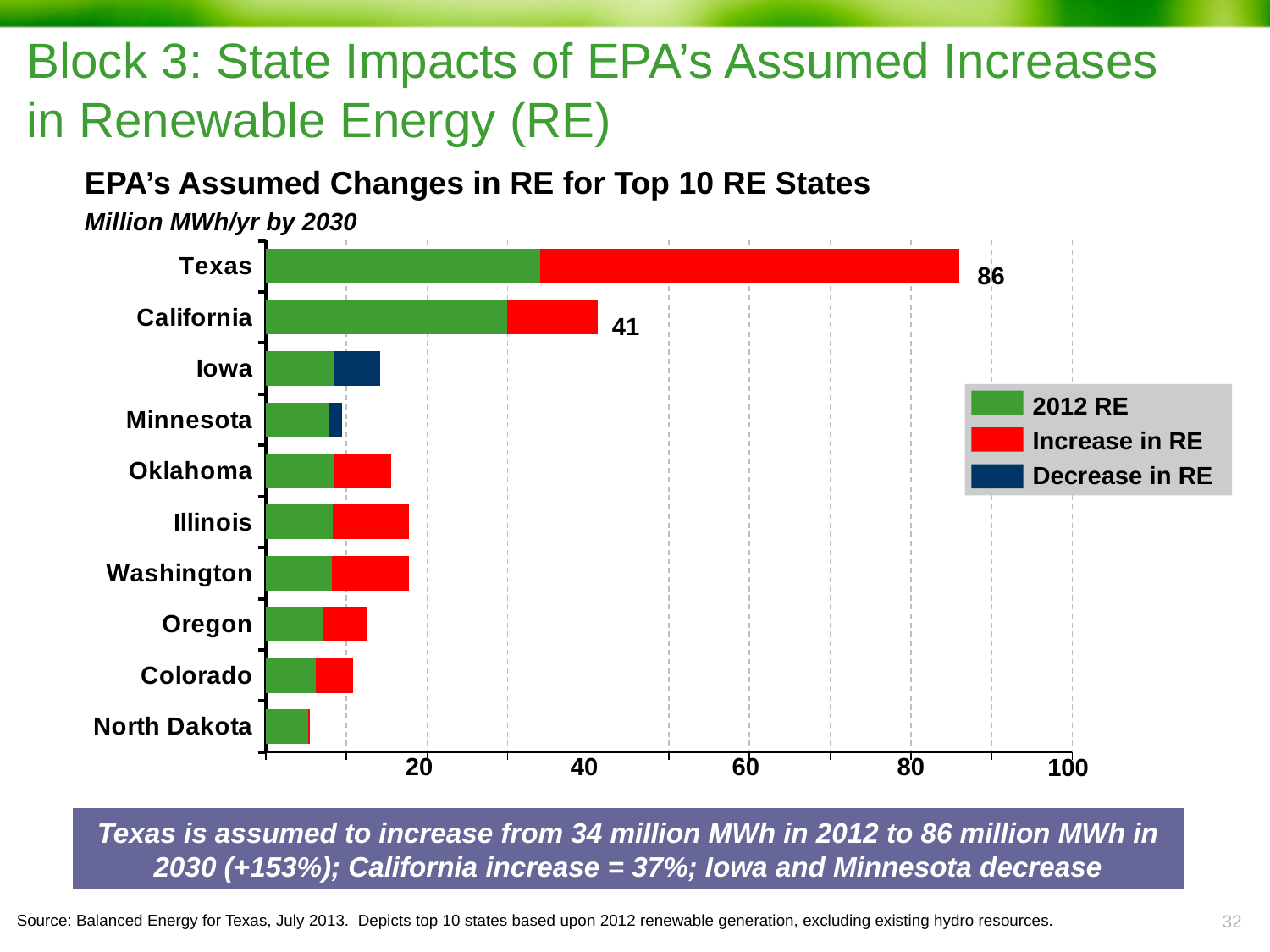
What are the three entries in the chart legend? 2012 RE, Increase in RE, Decrease in RE Is the total bar length for Iowa greater or less than 20? less What is the difference between the labelled totals for Texas and California? 45 Which has the longer bar, Illinois or Oregon? Illinois Is the total bar length for Texas greater or less than 80? greater What is the total value labelled for California? 41 What kind of chart is shown on the slide? bar chart What is the total value labelled for Texas? 86 How many states are shown in the chart? 10 Which state has the longest bar in the chart? Texas How many series does the chart legend list? 3 Which state has the shortest bar in the chart? North Dakota